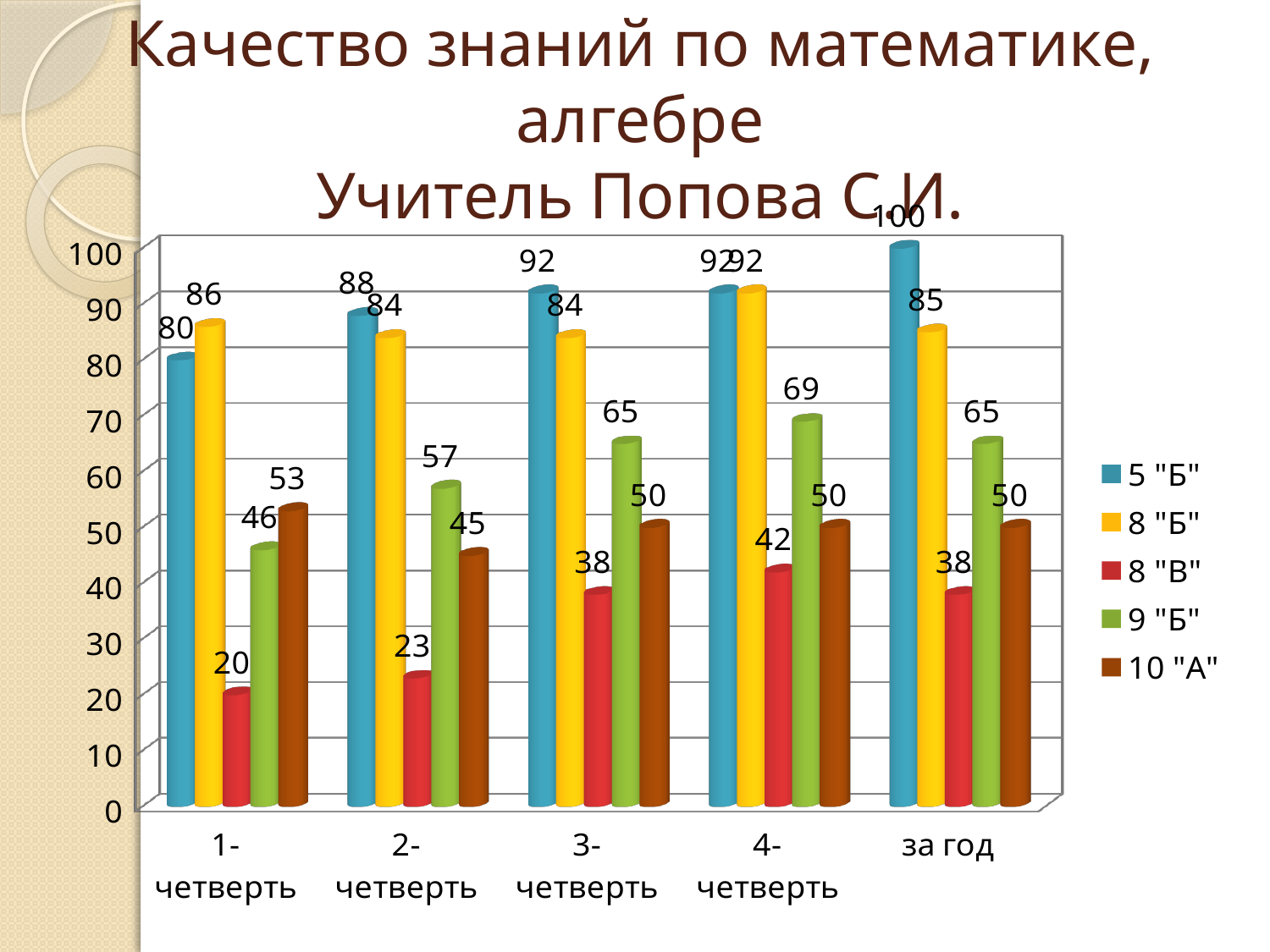
How many series does the legend list? 5 Do the values for 8 "В" rise or fall from 1-четверть to 4-четверть? rise What is the value for 5 "Б" for за год? 100 What is the value for 5 "Б" in 1-четверть? 80 What is the difference between the 8 "Б" value and the 8 "В" value in 1-четверть? 66 What kind of chart is shown on the slide? bar chart How many categories are shown on the x axis? 5 Which is larger in 2-четверть: 5 "Б" or 8 "Б"? 5 "Б" What is the value for 9 "Б" in 4-четверть? 69 What is the value for 8 "В" in 2-четверть? 23 In which category does 5 "Б" reach its highest value? за год Which series has the lowest value in 3-четверть? 8 "В"